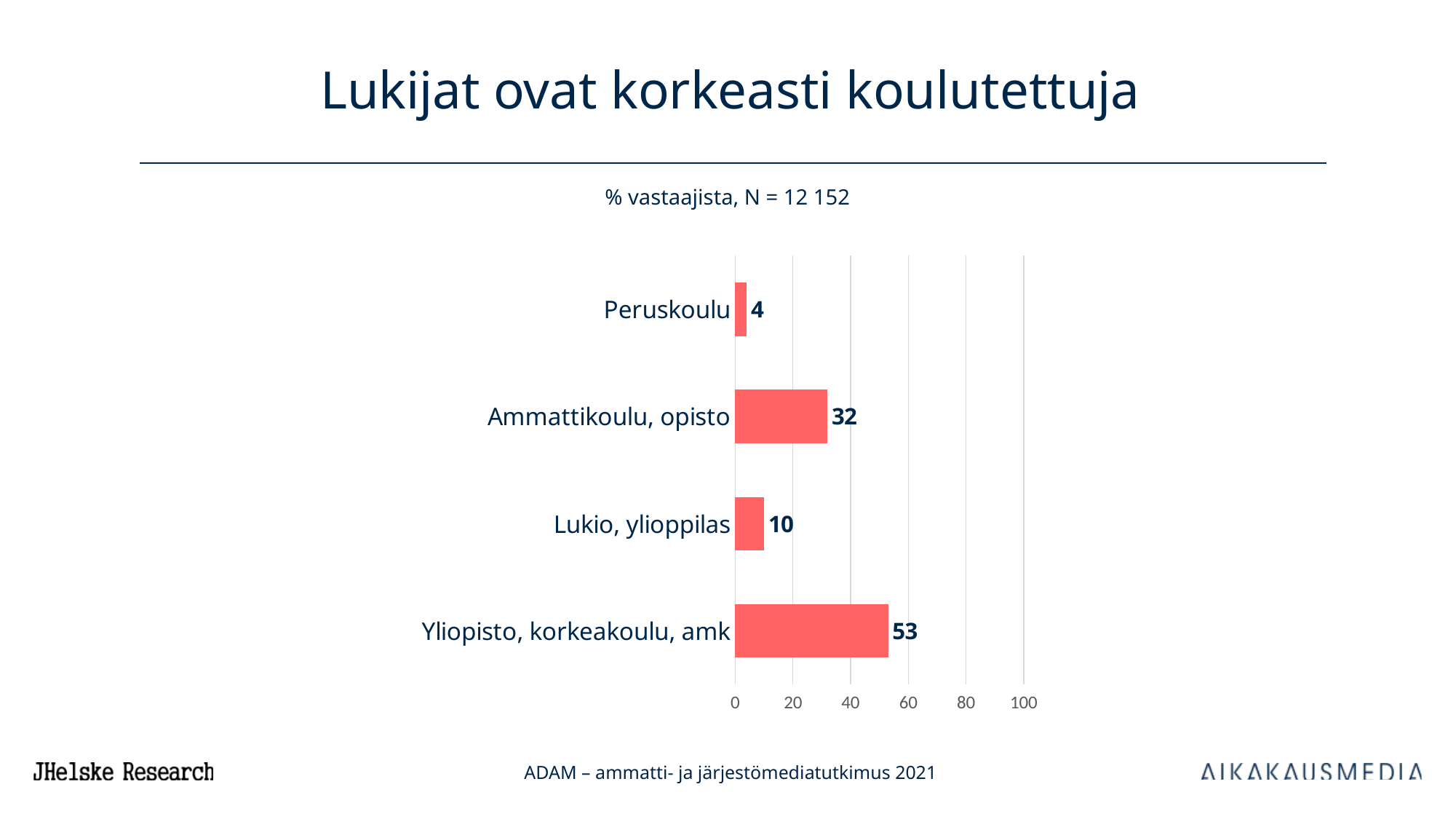
Which is larger, the value for Lukio, ylioppilas or the value for Ammattikoulu, opisto? Ammattikoulu, opisto Which category has the highest value? Yliopisto, korkeakoulu, amk What is the value for Peruskoulu? 4 What is the title of the slide? Lukijat ovat korkeasti koulutettuja How many categories are shown in the chart? 4 Is the value for Yliopisto, korkeakoulu, amk greater or less than 40? greater What kind of chart is shown on the slide? bar chart What is the value for Ammattikoulu, opisto? 32 What is the value for Yliopisto, korkeakoulu, amk? 53 What is the value for Lukio, ylioppilas? 10 Which category has the lowest value? Peruskoulu What is the difference between the values for Yliopisto, korkeakoulu, amk and Ammattikoulu, opisto? 21